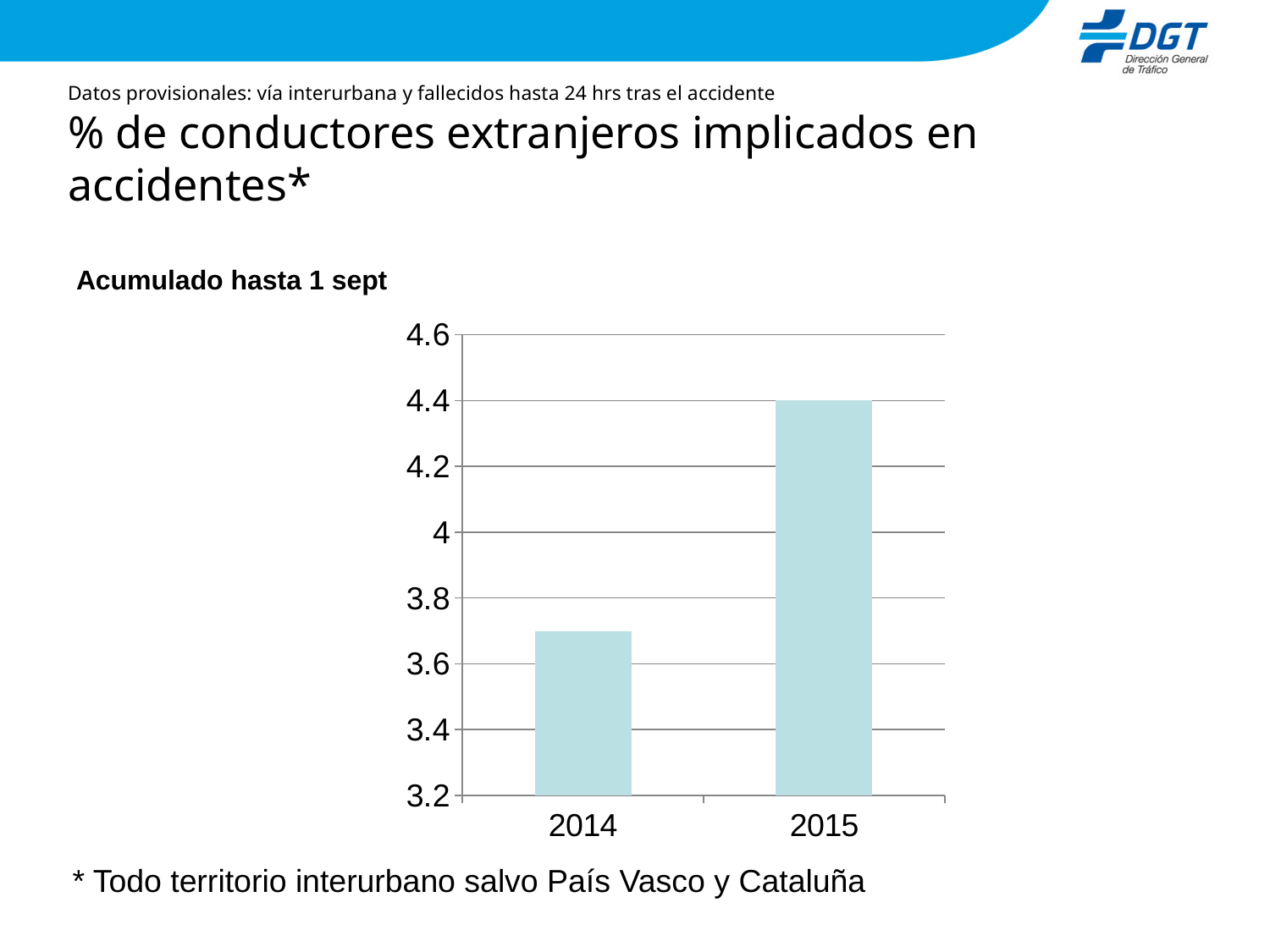
Is the value for 2015 greater or less than 4? greater How many bars (categories) does the chart show? 2 Is the value for 2014 greater or less than 3.6? greater Which year has the lower value in the chart? 2014 Do the values rise or fall from 2014 to 2015? rise What is the lowest value shown on the y axis of the chart? 3.2 Is the value for 2014 greater or less than 3.8? less Is the value for 2015 larger or smaller than the value for 2014? larger What value does the bar for 2015 reach on the y axis? 4.4 Which year has the higher percentage of foreign drivers involved in accidents? 2015 What label appears above the chart describing the period covered? Acumulado hasta 1 sept What kind of chart is shown on the slide? bar chart